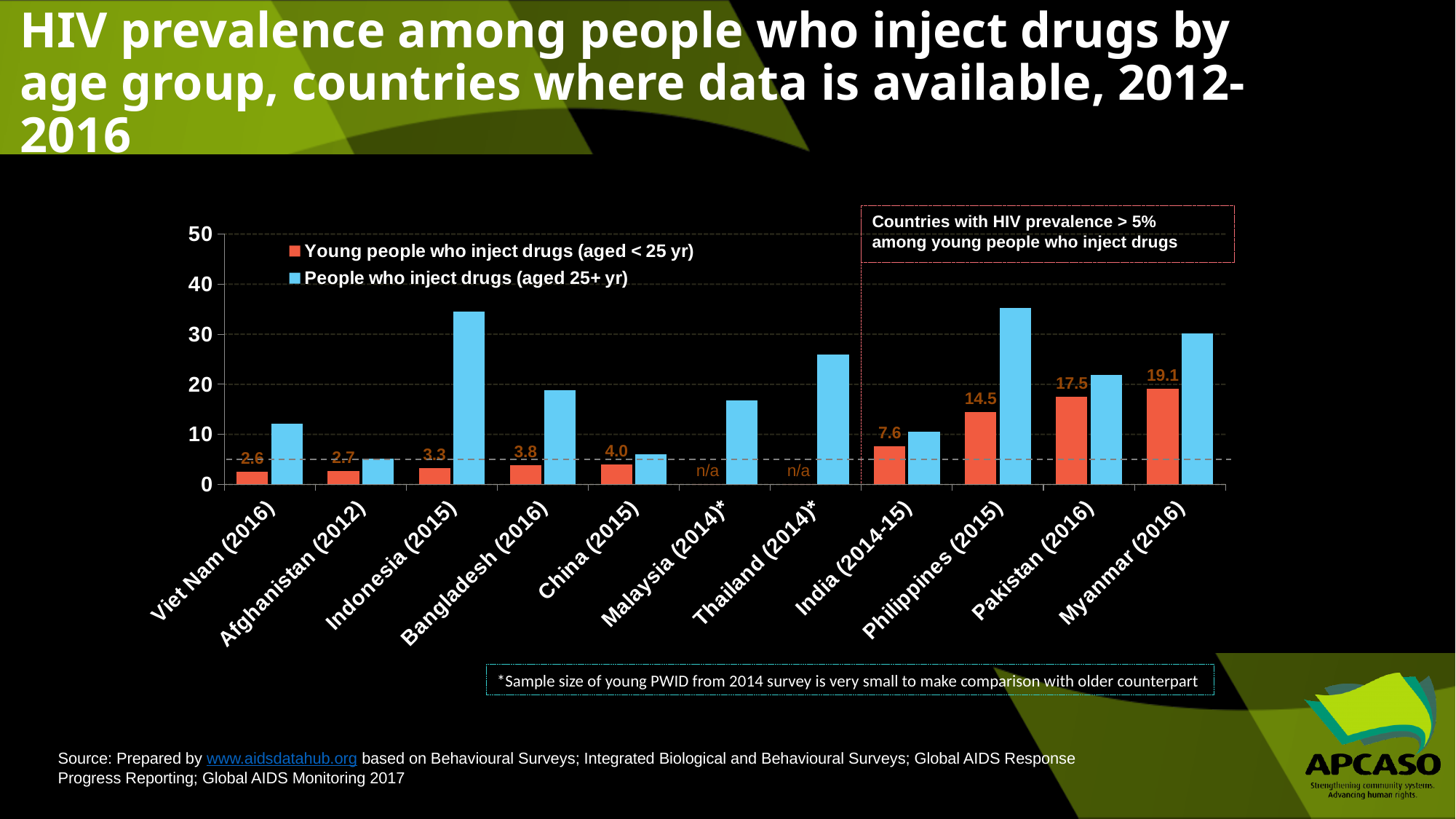
How many series does the chart legend list? 2 Is the value for people who inject drugs (aged 25+ yr) in Indonesia (2015) greater or less than 30? greater What is the difference between the young people (aged < 25 yr) values for Pakistan (2016) and Philippines (2015)? 3.0 Which is larger for young people who inject drugs (aged < 25 yr): Myanmar (2016) or Pakistan (2016)? Myanmar (2016) Which country has the lowest value for young people who inject drugs (aged < 25 yr)? Viet Nam (2016) Which country has the highest value for young people who inject drugs (aged < 25 yr)? Myanmar (2016) How many countries are shown on the x axis of the chart? 11 What kind of chart is shown on the slide? bar chart Is the value for people who inject drugs (aged 25+ yr) in Afghanistan (2012) greater or less than 10? less Which is larger for people who inject drugs (aged 25+ yr): Thailand (2014)* or Malaysia (2014)*? Thailand (2014)* What is the HIV prevalence value for young people who inject drugs (aged < 25 yr) in Myanmar (2016)? 19.1 What is the value for young people who inject drugs (aged < 25 yr) in India (2014-15)? 7.6